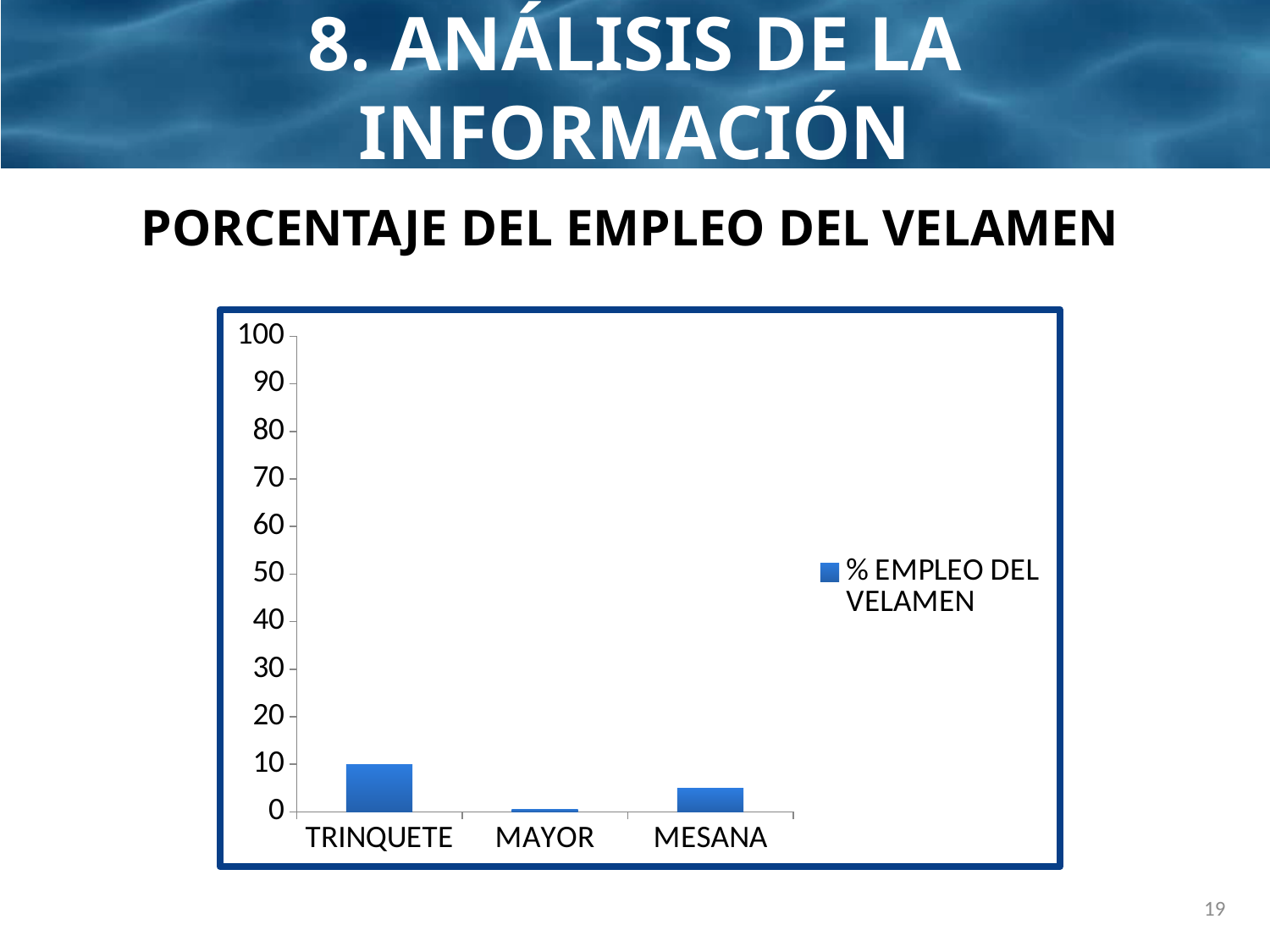
How many series does the legend list? 1 What type of chart is shown on the slide? bar chart Which category has the lowest value in the chart? MAYOR Is the value for TRINQUETE greater or less than 20? less What is the value for TRINQUETE? 10 Which is larger, the value for MESANA or the value for MAYOR? MESANA What is the title shown above the chart? PORCENTAJE DEL EMPLEO DEL VELAMEN Which is larger, the value for TRINQUETE or the value for MESANA? TRINQUETE Which category has the highest value in the chart? TRINQUETE Is the value for MESANA greater or less than 10? less How many categories are shown on the x axis of the chart? 3 What is the name of the series shown in the legend? % EMPLEO DEL VELAMEN